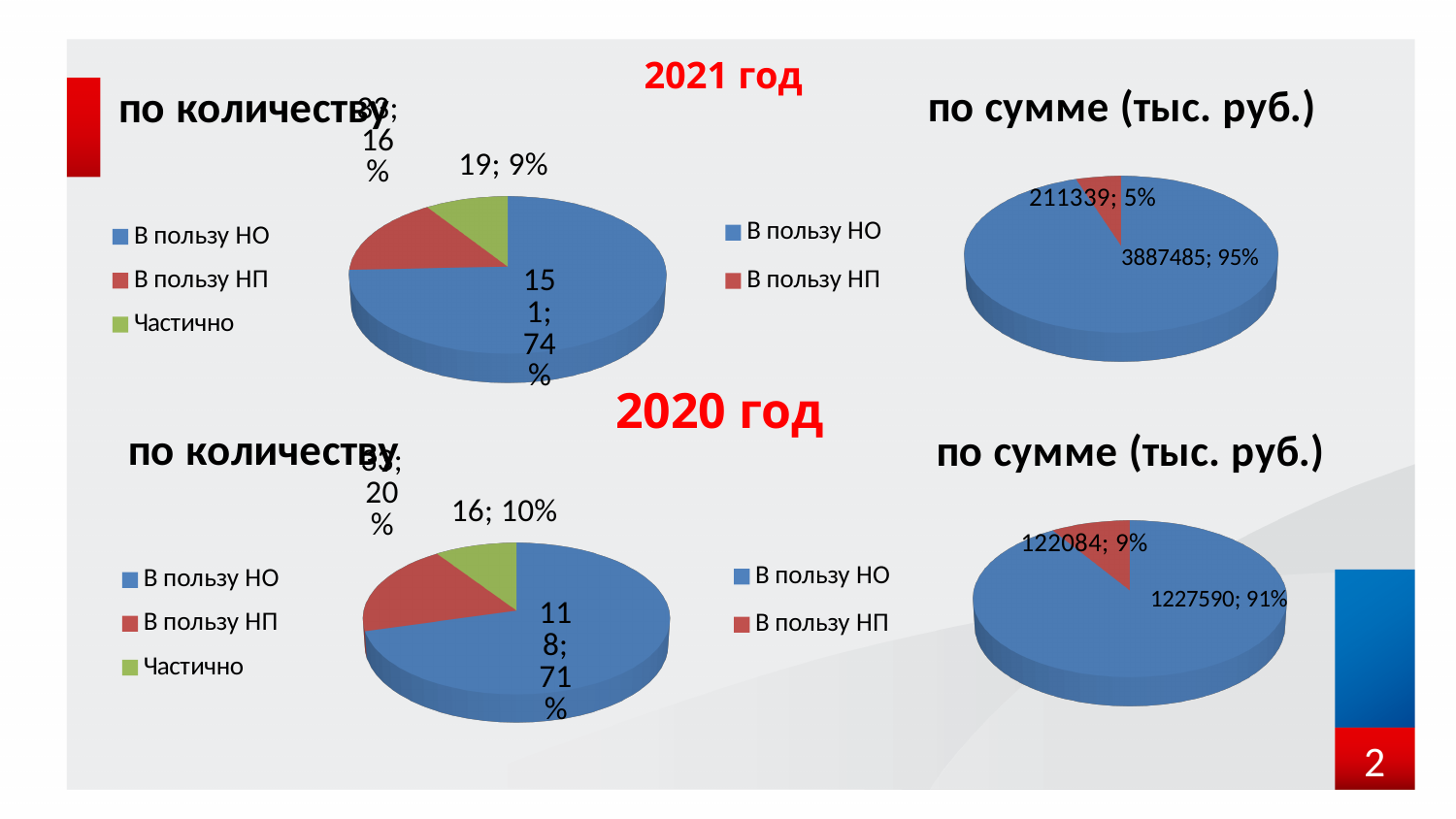
In the 2020 'по сумме (тыс. руб.)' pie chart, what is the value for 'В пользу НП'? 122084 In the 2021 'по сумме (тыс. руб.)' pie chart, which category has the largest slice? В пользу НО In the 2021 'по сумме (тыс. руб.)' pie chart, what share does 'В пользу НП' have? 5% In the 2021 'по сумме (тыс. руб.)' pie chart, what is the value for 'В пользу НО'? 3887485 In the 2020 'по количеству' pie chart, what is the data label for the 'В пользу НО' slice? 118; 71% In the 2021 'по количеству' pie chart, what is the data label for the 'Частично' slice? 19; 9% What type of chart is the 2020 'по сумме (тыс. руб.)' chart? Pie chart In the 2020 'по количеству' pie chart, what share does 'Частично' have? 10% How many categories does the legend of the 2021 'по количеству' chart list? 3 In the 2021 'по количеству' pie chart, what is the data label for the 'В пользу НО' slice? 151; 74% In the 2020 'по сумме (тыс. руб.)' pie chart, what share does 'В пользу НО' have? 91% In the 2020 'по количеству' pie chart, which category has the smallest slice? Частично